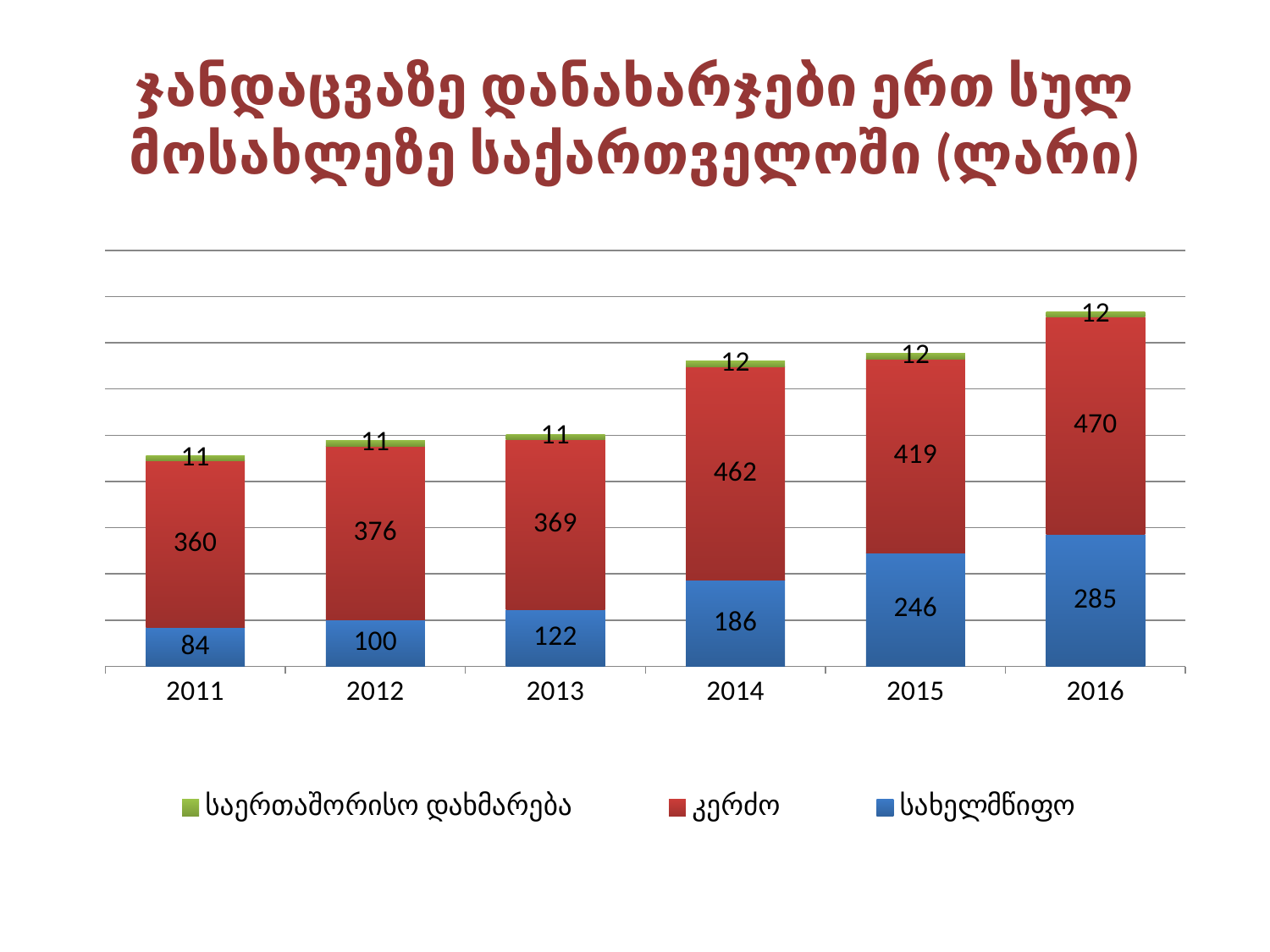
What is the difference between the სახელმწიფო values for 2016 and 2011? 201 What is the total of the stacked bar for 2016? 767 Which is larger, the კერძო value for 2014 or for 2015? 2014 Does the სახელმწიფო value rise or fall from 2011 to 2016? Rise In which year is the სახელმწიფო value highest? 2016 What kind of chart is shown on the slide? Stacked bar chart How many years are shown on the x axis? 6 How many series does the legend list? 3 In which year is the კერძო value lowest? 2011 What is the value for საერთაშორისო დახმარება in 2016? 12 What is the value for კერძო in 2012? 376 What is the value for სახელმწიფო in 2014? 186